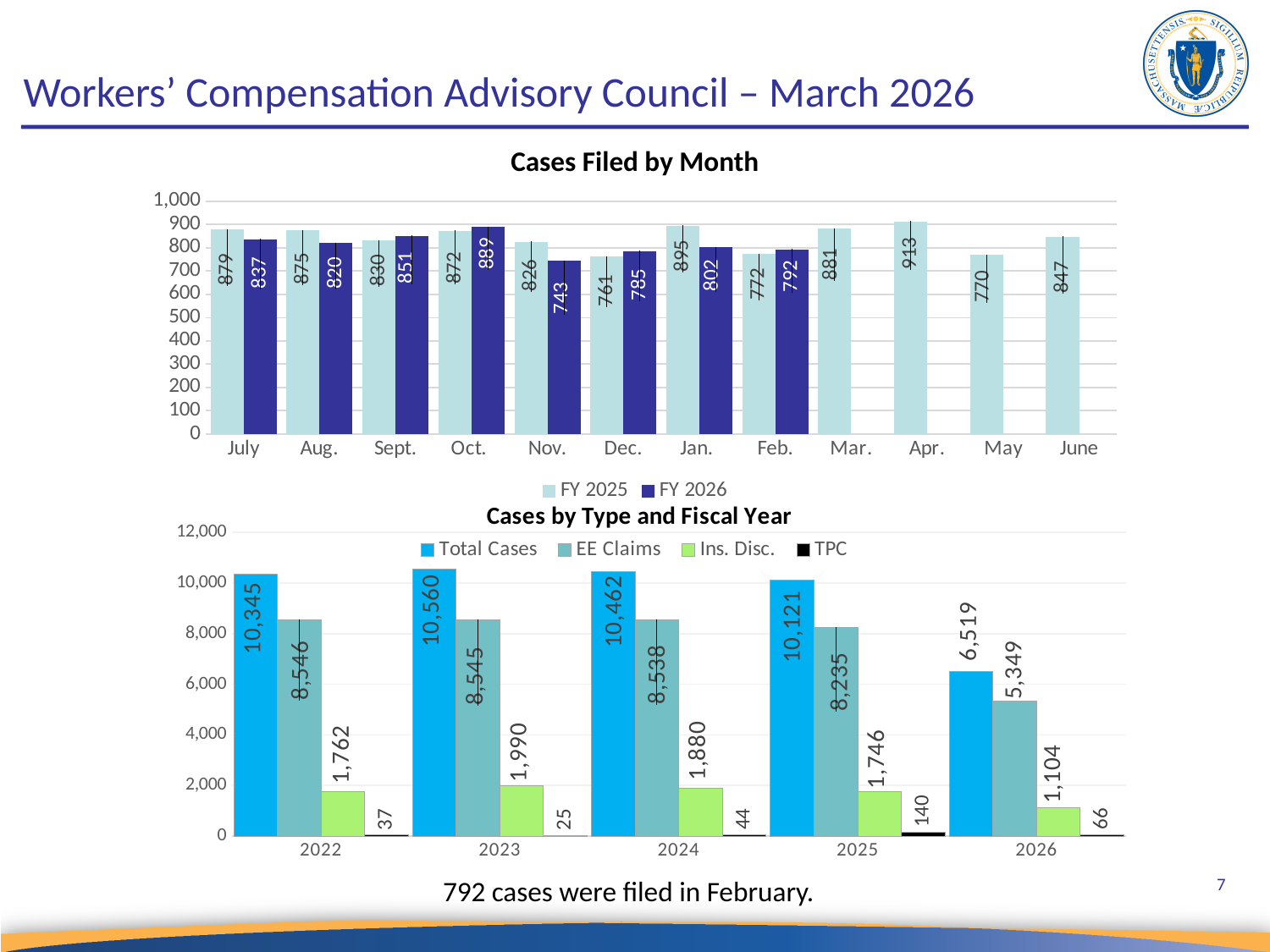
In the 'Cases Filed by Month' chart, which month has the lowest FY 2026 value? Nov. In the 'Cases by Type and Fiscal Year' chart, which year has the lowest Total Cases value? 2026 In the 'Cases Filed by Month' chart, which month has the highest FY 2025 value? Apr. In the 'Cases Filed by Month' chart, which is larger for Oct.: FY 2025 or FY 2026? FY 2026 In the 'Cases by Type and Fiscal Year' chart, what is the Total Cases value for 2023? 10,560 In the 'Cases Filed by Month' chart, what is the FY 2026 value for Feb.? 792 In the 'Cases Filed by Month' chart, what is the difference between the FY 2025 and FY 2026 values for Nov.? 83 What kind of chart is the 'Cases by Type and Fiscal Year' chart? Bar chart In the 'Cases Filed by Month' chart, what is the FY 2025 value for Apr.? 913 In the 'Cases by Type and Fiscal Year' chart, what is the TPC value for 2025? 140 In the 'Cases Filed by Month' chart, how many series does the legend list? 2 In the 'Cases by Type and Fiscal Year' chart, what is the difference between EE Claims in 2022 and 2025? 311